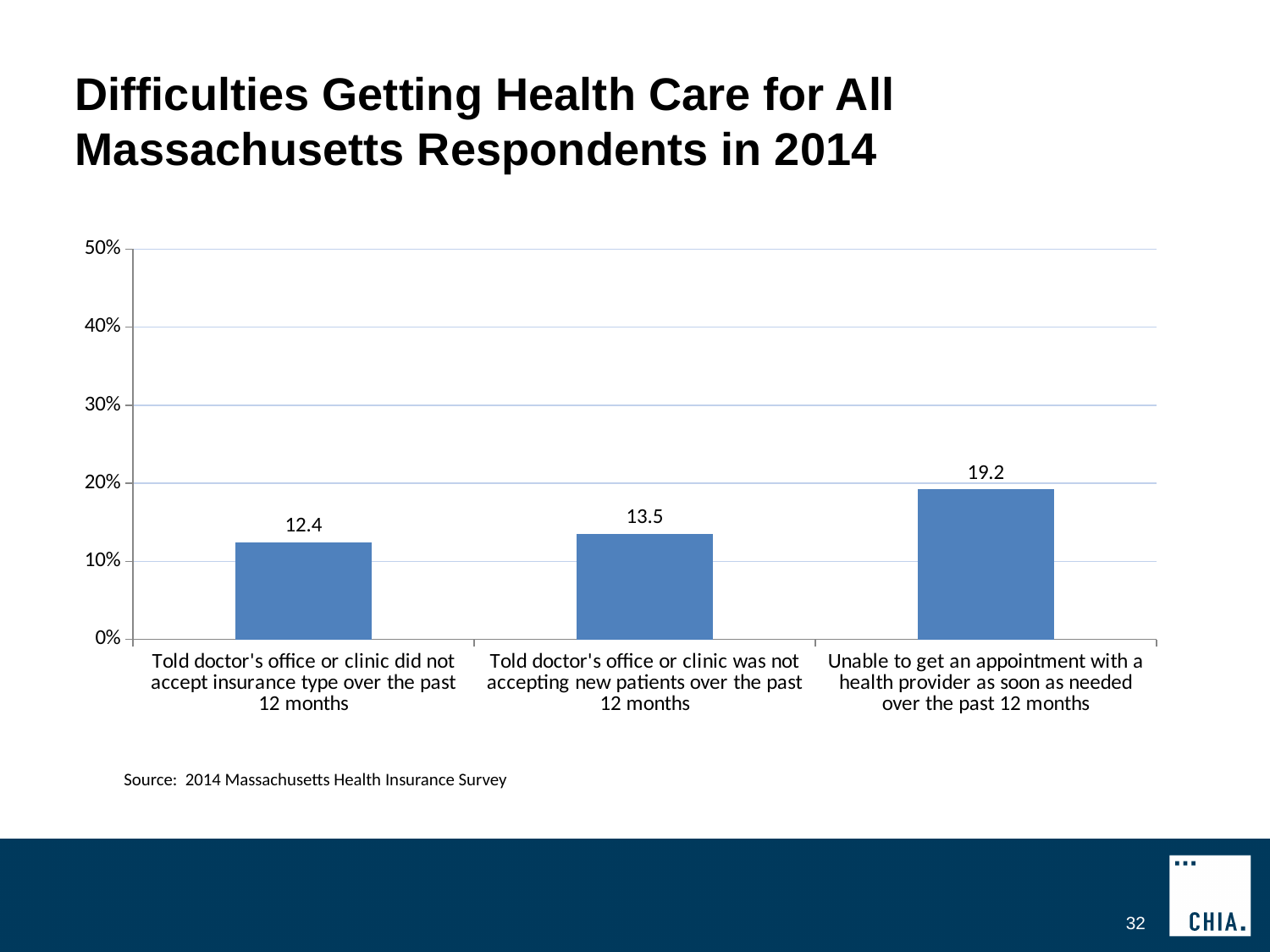
What is the value for 'Told doctor's office or clinic did not accept insurance type over the past 12 months'? 12.4 How many categories are shown in the chart? 3 Which is larger: the value for 'Told doctor's office or clinic was not accepting new patients over the past 12 months' or the value for 'Unable to get an appointment with a health provider as soon as needed over the past 12 months'? Unable to get an appointment with a health provider as soon as needed over the past 12 months What is the title of the chart on the slide? Difficulties Getting Health Care for All Massachusetts Respondents in 2014 What is the value for 'Unable to get an appointment with a health provider as soon as needed over the past 12 months'? 19.2 Which category has the highest value? Unable to get an appointment with a health provider as soon as needed over the past 12 months What is the value for 'Told doctor's office or clinic was not accepting new patients over the past 12 months'? 13.5 What is the difference between the value for 'Unable to get an appointment with a health provider as soon as needed over the past 12 months' and the value for 'Told doctor's office or clinic did not accept insurance type over the past 12 months'? 6.8 What is the difference between the value for 'Told doctor's office or clinic was not accepting new patients over the past 12 months' and the value for 'Told doctor's office or clinic did not accept insurance type over the past 12 months'? 1.1 Which category has the lowest value? Told doctor's office or clinic did not accept insurance type over the past 12 months What kind of chart is shown on the slide? Bar chart Is the value for 'Unable to get an appointment with a health provider as soon as needed over the past 12 months' greater or less than 20%? less